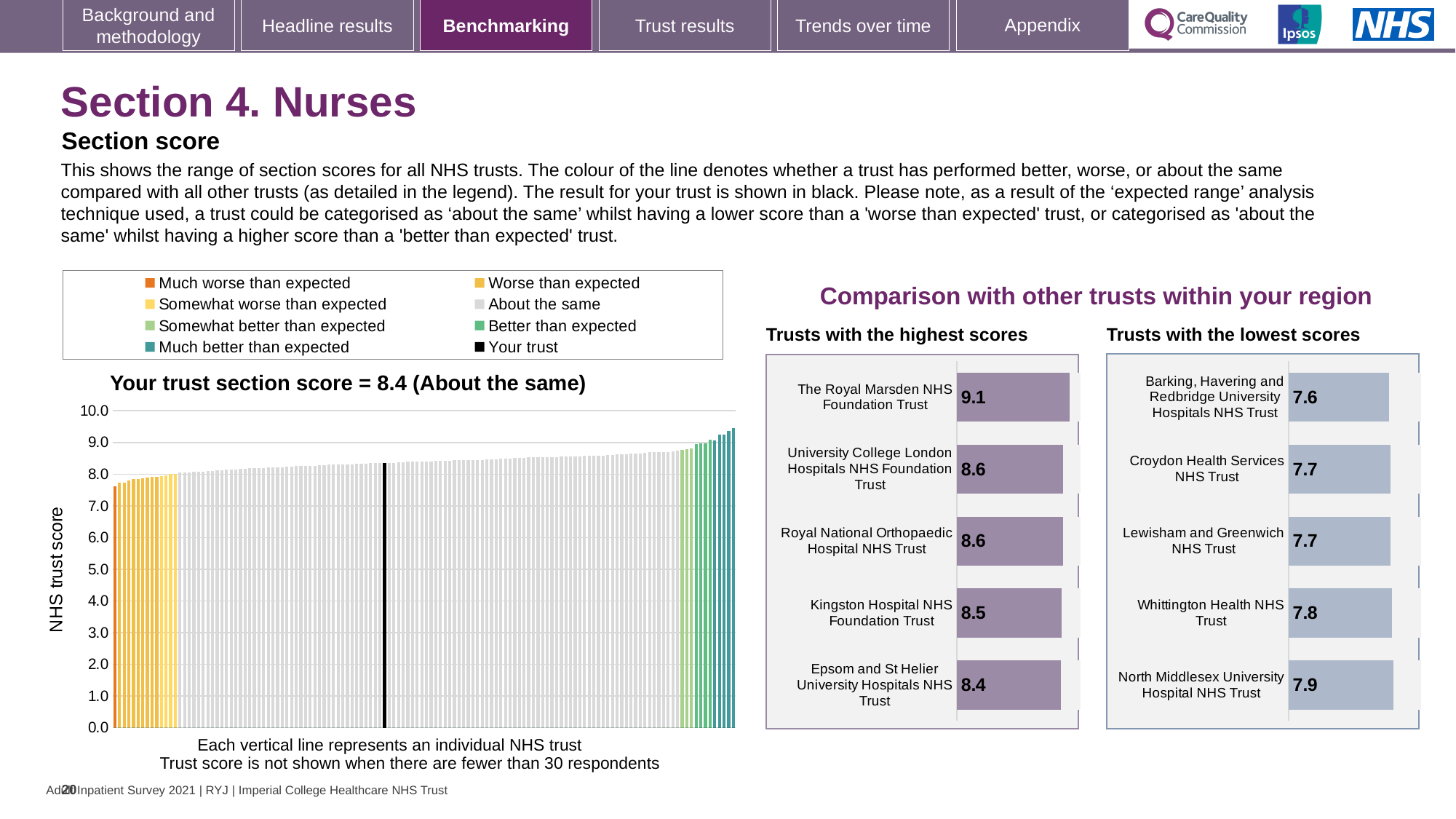
In the 'Trusts with the highest scores' chart, which trust has the highest score? The Royal Marsden NHS Foundation Trust In the 'Trusts with the lowest scores' chart, what is the score for Barking, Havering and Redbridge University Hospitals NHS Trust? 7.6 In the 'Trusts with the lowest scores' chart, which has the higher score: Croydon Health Services NHS Trust or North Middlesex University Hospital NHS Trust? North Middlesex University Hospital NHS Trust According to the title of the main chart on the left, what is your trust's section score? 8.4 How many entries does the legend of the main chart on the left list? 8 In the 'Trusts with the lowest scores' chart, which trust has the lowest score? Barking, Havering and Redbridge University Hospitals NHS Trust In the 'Trusts with the lowest scores' chart, what is the score for Whittington Health NHS Trust? 7.8 In the 'Trusts with the highest scores' chart, what is the score for Kingston Hospital NHS Foundation Trust? 8.5 In the 'Trusts with the highest scores' chart, what is the difference between the scores of The Royal Marsden NHS Foundation Trust and Epsom and St Helier University Hospitals NHS Trust? 0.7 In the 'Trusts with the highest scores' chart, what is the score for The Royal Marsden NHS Foundation Trust? 9.1 In the 'Trusts with the lowest scores' chart, what is the difference between the scores of North Middlesex University Hospital NHS Trust and Barking, Havering and Redbridge University Hospitals NHS Trust? 0.3 How many trusts are shown in the 'Trusts with the highest scores' chart? 5